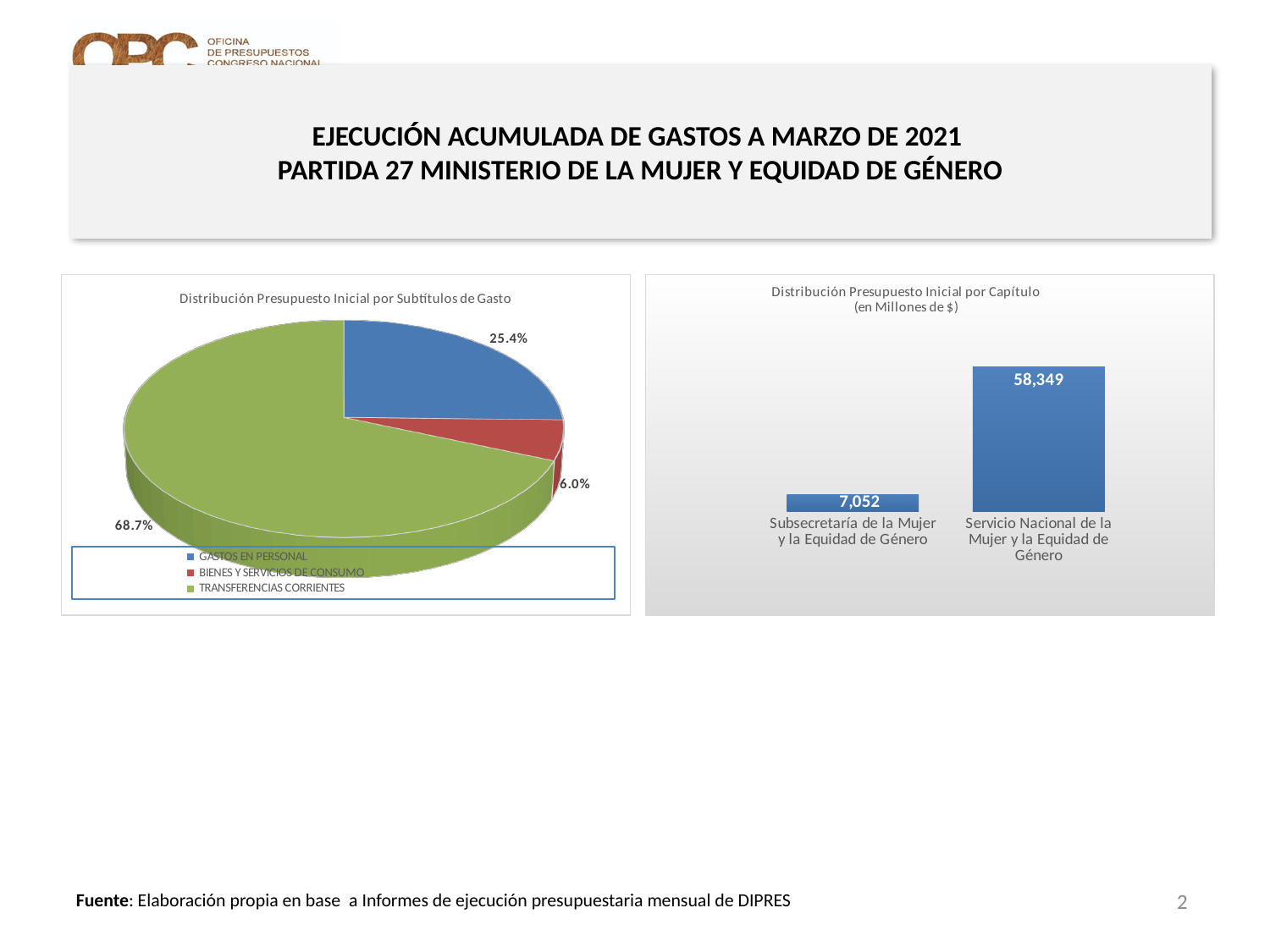
In the chart 'Distribución Presupuesto Inicial por Capítulo', what is the value for Servicio Nacional de la Mujer y la Equidad de Género? 58,349 In the pie chart 'Distribución Presupuesto Inicial por Subtítulos de Gasto', which category has the smallest slice? BIENES Y SERVICIOS DE CONSUMO What kind of chart is the one on the right, 'Distribución Presupuesto Inicial por Capítulo'? Bar chart In the pie chart 'Distribución Presupuesto Inicial por Subtítulos de Gasto', what share does BIENES Y SERVICIOS DE CONSUMO have? 6.0% In the pie chart 'Distribución Presupuesto Inicial por Subtítulos de Gasto', how many categories does the legend list? 3 In the chart 'Distribución Presupuesto Inicial por Capítulo', which capítulo has the larger value? Servicio Nacional de la Mujer y la Equidad de Género In the chart 'Distribución Presupuesto Inicial por Capítulo', what is the value for Subsecretaría de la Mujer y la Equidad de Género? 7,052 In the pie chart 'Distribución Presupuesto Inicial por Subtítulos de Gasto', what is the difference in percentage points between GASTOS EN PERSONAL and BIENES Y SERVICIOS DE CONSUMO? 19.4 In the chart 'Distribución Presupuesto Inicial por Capítulo', what is the difference between the two values? 51,297 In the pie chart 'Distribución Presupuesto Inicial por Subtítulos de Gasto', what share does TRANSFERENCIAS CORRIENTES have? 68.7% In the pie chart 'Distribución Presupuesto Inicial por Subtítulos de Gasto', what share does GASTOS EN PERSONAL have? 25.4% In the pie chart 'Distribución Presupuesto Inicial por Subtítulos de Gasto', which category has the largest slice? TRANSFERENCIAS CORRIENTES